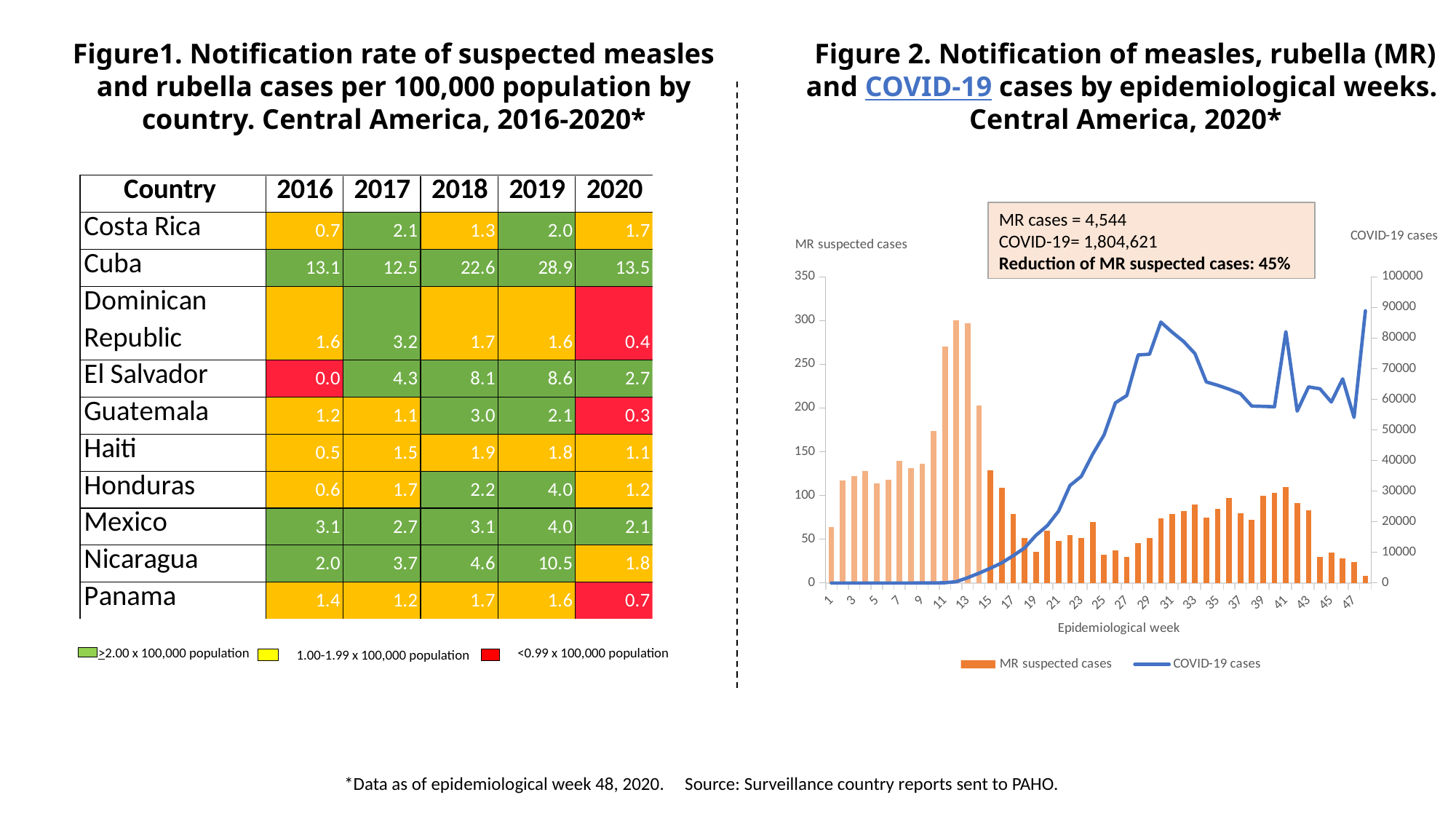
In Figure 2, is the number of MR suspected cases in epidemiological week 1 greater or less than 100? less In Figure 2, which has more MR suspected cases: epidemiological week 12 or epidemiological week 1? Week 12 In Figure 2, what reduction of MR suspected cases is stated in the text box? 45% In Figure 2, does the COVID-19 cases line rise or fall between epidemiological week 10 and epidemiological week 30? Rise In Figure 2, how many series does the legend list? 2 In Figure 2, is the number of COVID-19 cases in epidemiological week 20 greater or less than 30000? less In Figure 2, which series is drawn as a line? COVID-19 cases In Figure 2, what total number of MR cases is stated in the text box? 4,544 In Figure 2, is the number of MR suspected cases in epidemiological week 12 greater or less than 250? greater In Figure 2, what kind of chart is used to show the data? A bar chart combined with a line In Figure 2, what is the label of the x axis? Epidemiological week In Figure 2, what total number of COVID-19 cases is stated in the text box? 1,804,621